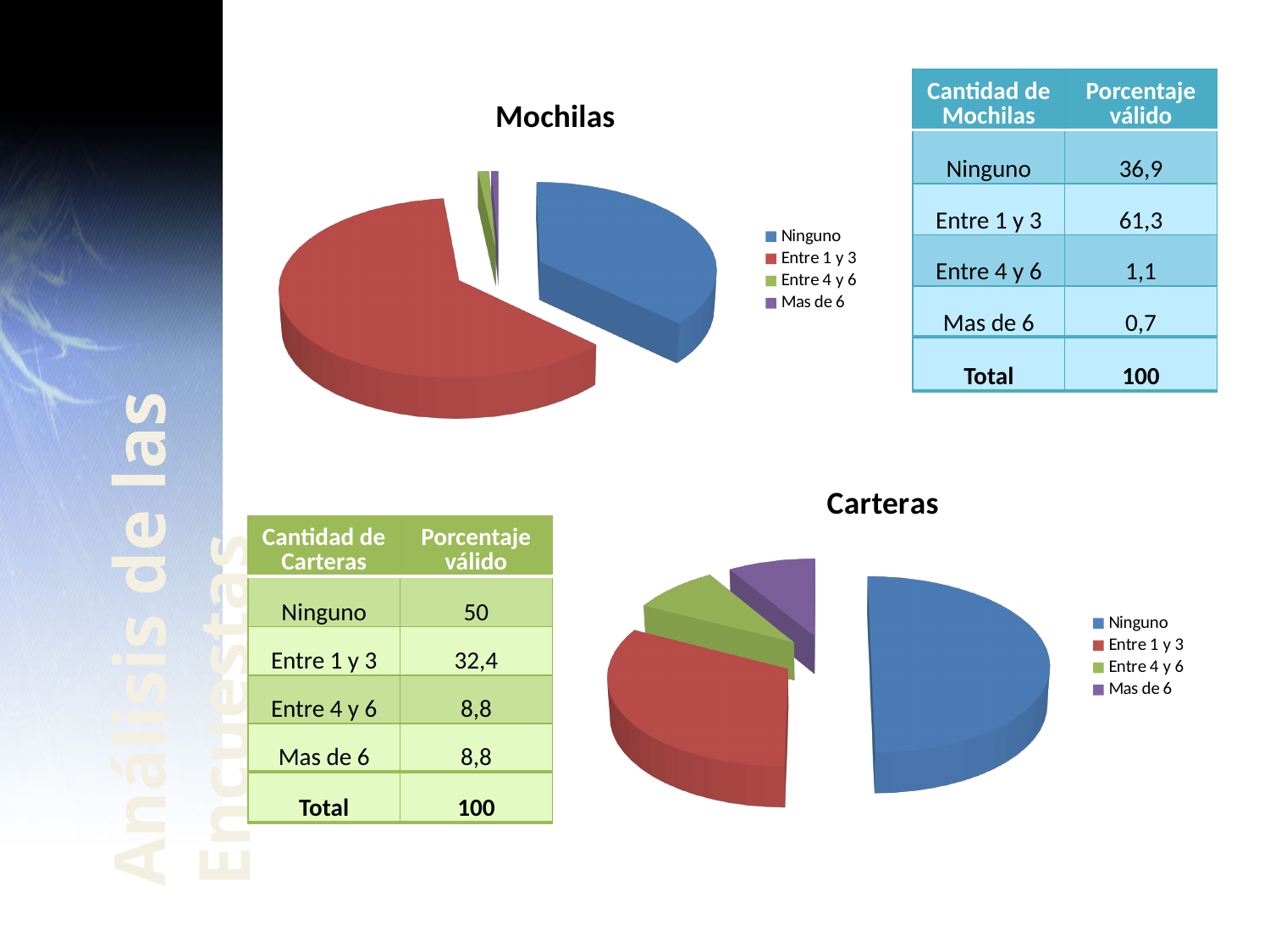
What kind of chart is the "Mochilas" chart? pie chart In the "Carteras" chart, is the slice for "Ninguno" larger or smaller than the slice for "Entre 1 y 3"? larger In the "Mochilas" chart, which category has the smallest slice? Mas de 6 Using the table values, what is the difference between the "Ninguno" percentages of the "Carteras" chart and the "Mochilas" chart? 13,1 In the "Mochilas" chart, which category has the largest slice? Entre 1 y 3 What colour is the "Entre 1 y 3" slice in the "Carteras" chart? red According to the table next to the "Mochilas" chart, what is the valid percentage for "Ninguno"? 36,9 According to the table next to the "Mochilas" chart, what is the valid percentage for "Entre 4 y 6"? 1,1 According to the table next to the "Carteras" chart, what is the valid percentage for "Mas de 6"? 8,8 According to the table next to the "Carteras" chart, what is the valid percentage for "Entre 1 y 3"? 32,4 In the "Carteras" chart, which category has the largest slice? Ninguno How many categories does the legend of the "Mochilas" chart list? 4